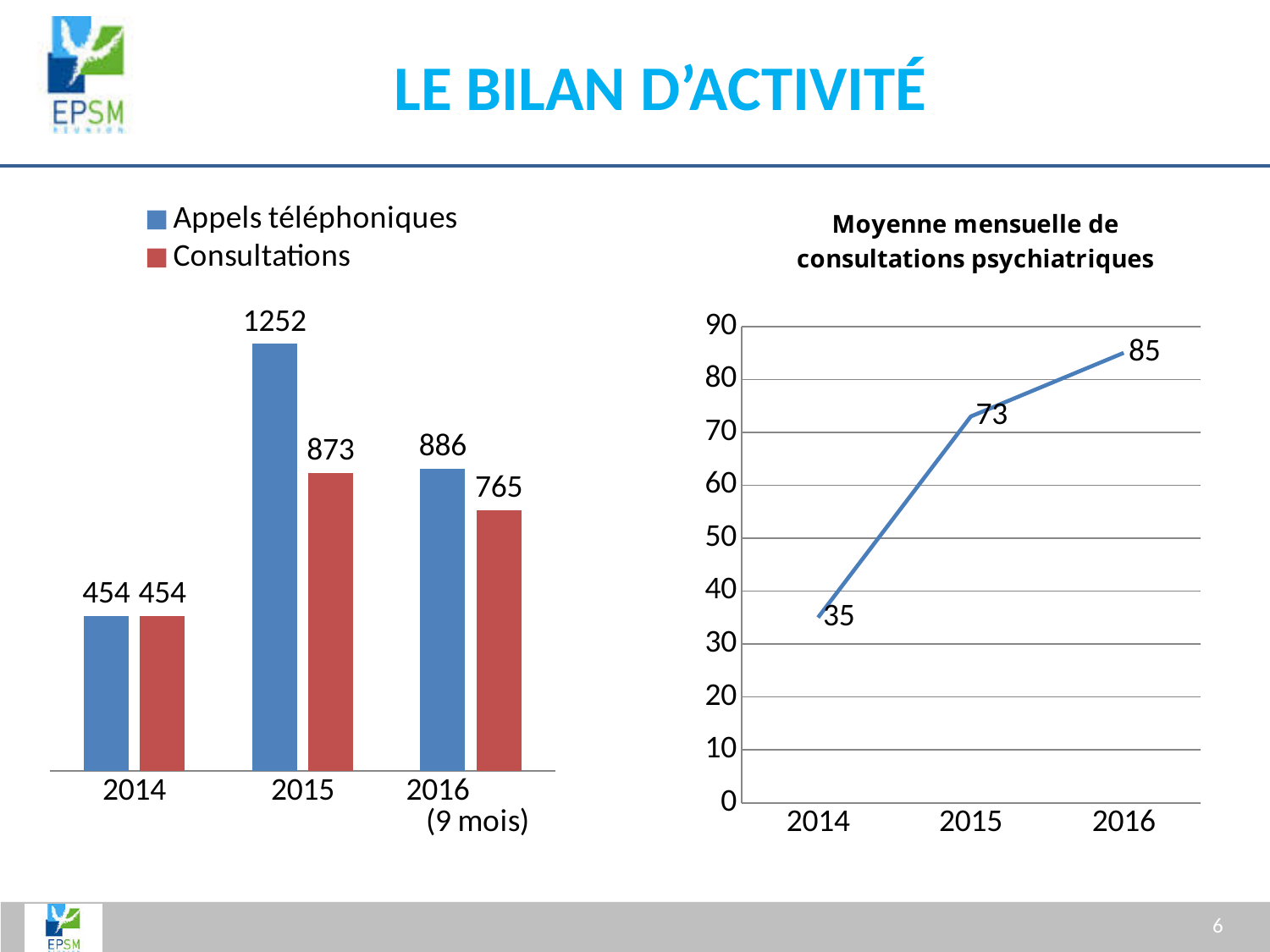
In the chart titled 'Moyenne mensuelle de consultations psychiatriques', which year has the lowest value? 2014 In the bar chart on the left, what is the value for Appels téléphoniques in 2015? 1252 How many series does the legend of the bar chart on the left list? 2 What kind of chart is the chart on the left? bar chart What kind of chart is the chart titled 'Moyenne mensuelle de consultations psychiatriques'? line chart In the chart titled 'Moyenne mensuelle de consultations psychiatriques', do the values rise or fall from 2014 to 2016? rise In the bar chart on the left, what is the value for Consultations in 2016 (9 mois)? 765 In the bar chart on the left, which is larger in 2016 (9 mois): Appels téléphoniques or Consultations? Appels téléphoniques In the bar chart on the left, which year has the highest value for Appels téléphoniques? 2015 In the chart titled 'Moyenne mensuelle de consultations psychiatriques', what is the difference between the 2016 and 2014 values? 50 In the chart titled 'Moyenne mensuelle de consultations psychiatriques', what is the value for 2015? 73 In the bar chart on the left, what is the difference between Appels téléphoniques and Consultations in 2015? 379